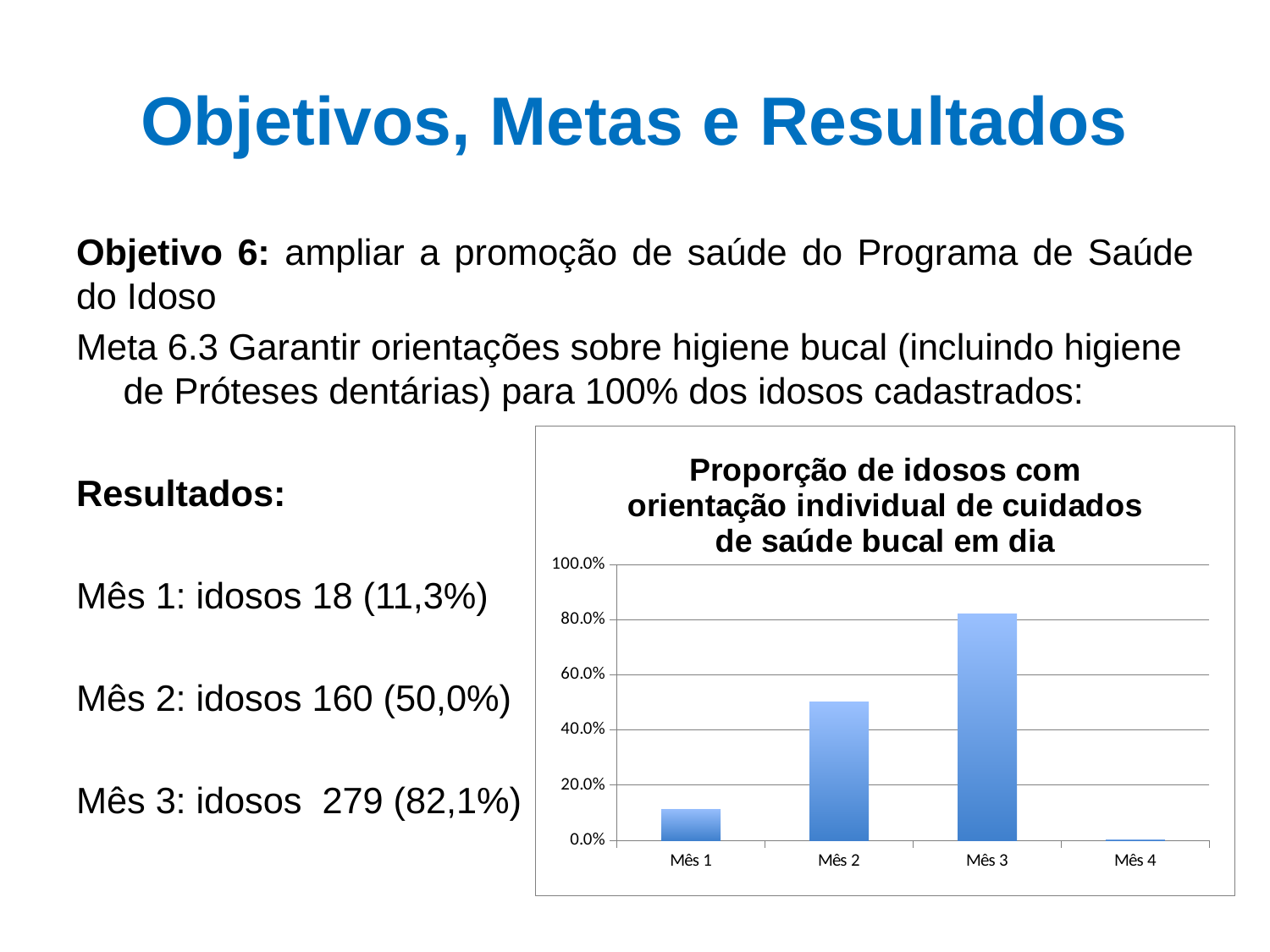
Do the values rise or fall from Mês 1 to Mês 3? rise Which category has the highest bar in the chart? Mês 3 What kind of chart is shown on the slide? Bar chart Which category has the lowest bar in the chart? Mês 4 What is the title of the chart? Proporção de idosos com orientação individual de cuidados de saúde bucal em dia How many categories are shown on the x axis of the chart? 4 Is the value for Mês 3 greater or less than 80.0%? greater Is the value for Mês 1 greater or less than 20.0%? less Is the value for Mês 3 greater or less than 100.0%? less Which is larger, the value for Mês 2 or the value for Mês 3? Mês 3 What is the highest value shown on the y axis of the chart? 100.0%